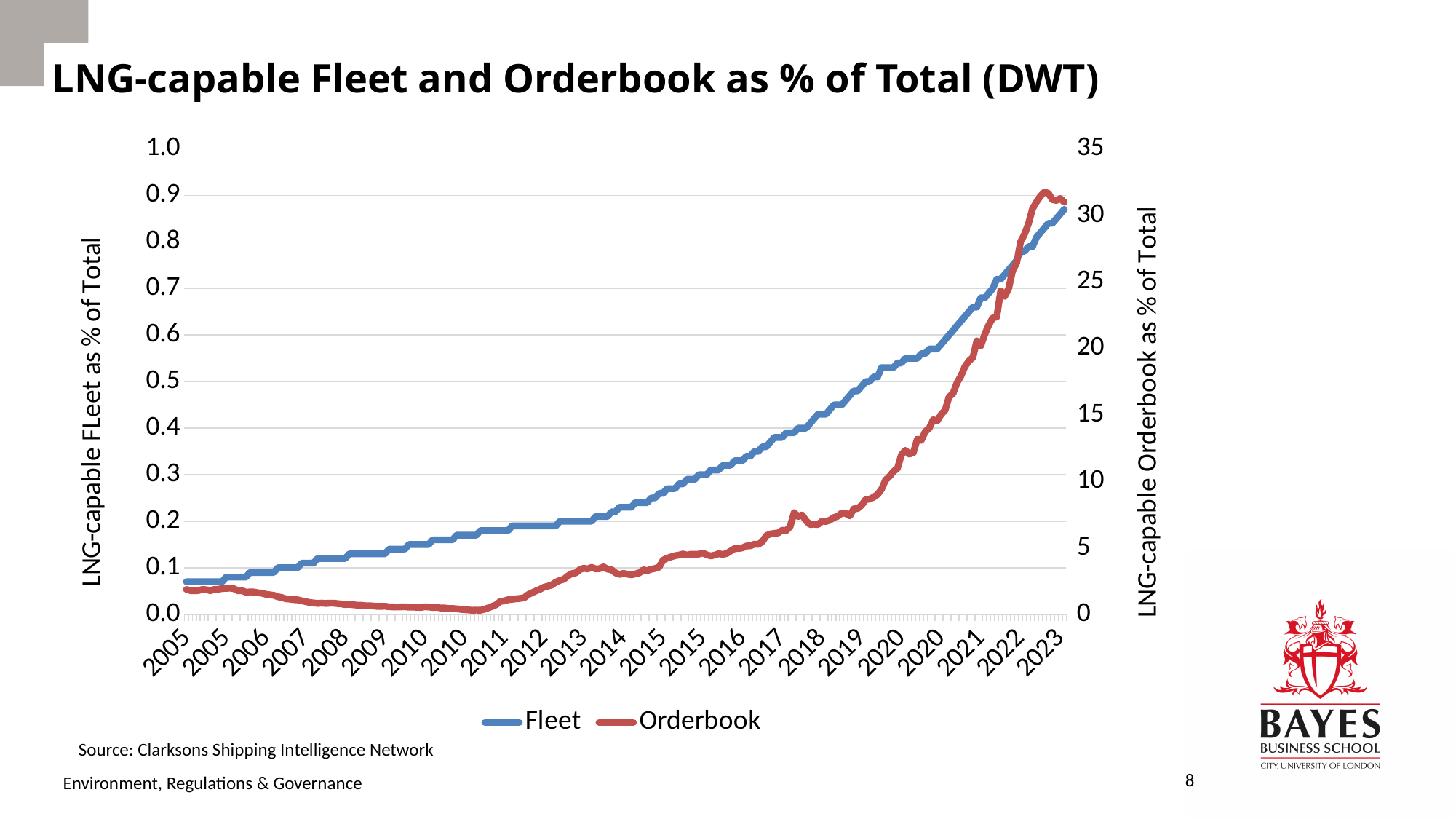
Is the Orderbook value in 2011 greater or less than 5? less Does the Orderbook series rise or fall between 2005 and 2011? Fall How many series does the legend list? 2 Is the Fleet value in 2005 greater or less than 0.1? less What is the title of the chart? LNG-capable Fleet and Orderbook as % of Total (DWT) Is the Fleet value in 2020 greater or less than 0.5? greater What kind of chart is shown on the slide? Line chart Does the Fleet series rise or fall from 2005 to 2023? Rise What is the label of the right-hand vertical axis? LNG-capable Orderbook as % of Total